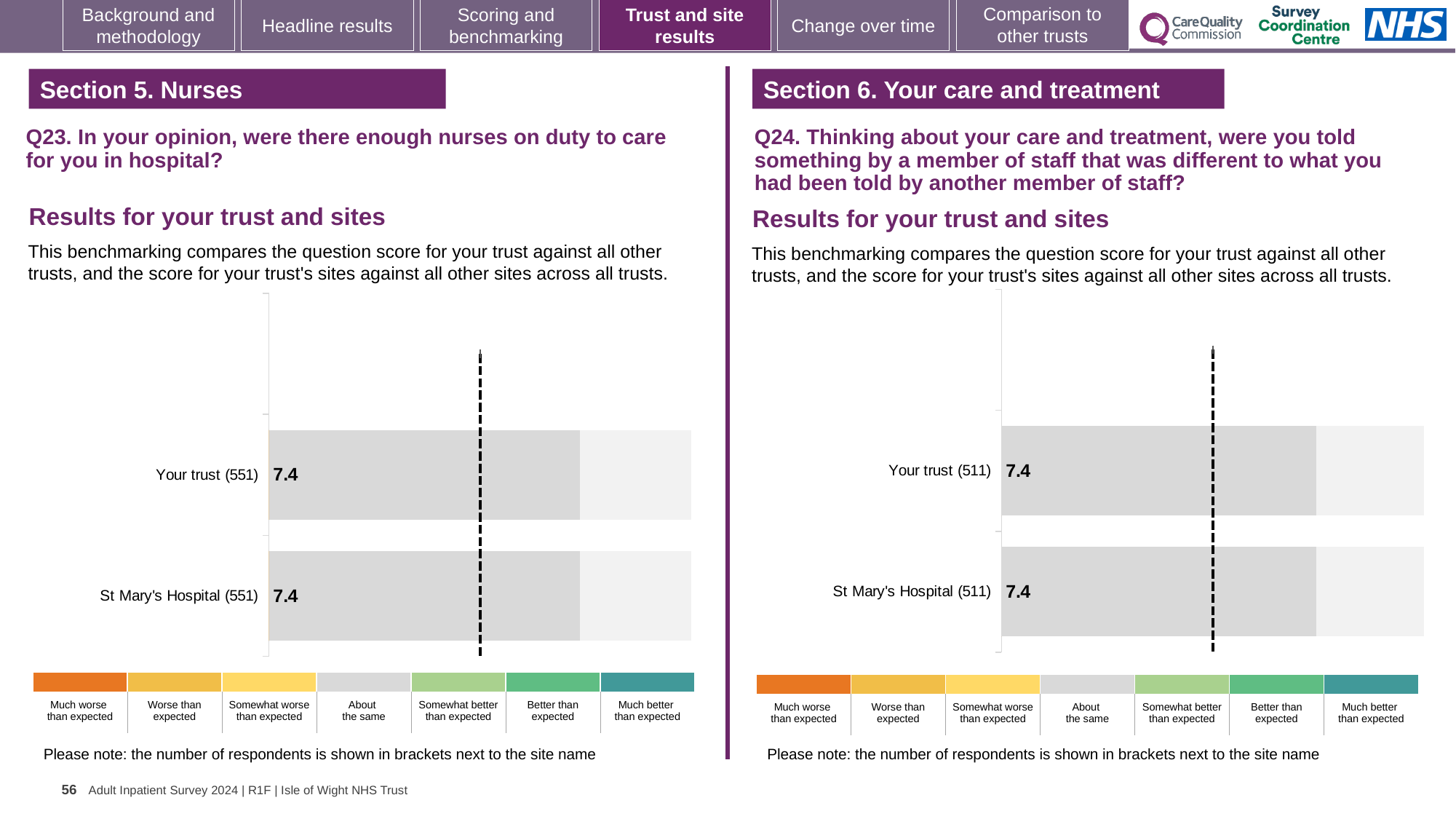
On the Q23 chart (left), how many respondents are shown in brackets next to Your trust? 551 On the Q24 chart (right), how many respondents are shown in brackets next to St Mary's Hospital? 511 How many bars are plotted on the Q23 chart (left)? 2 On the Q24 chart (right), what is the difference between the score for Your trust and the score for St Mary's Hospital? 0 On the Q23 chart (left), what is the difference between the score for Your trust and the score for St Mary's Hospital? 0 On the Q23 chart (left), what is the score for Your trust? 7.4 On the Q23 chart (left), what is the score for St Mary's Hospital? 7.4 On the Q24 chart (right), what is the score for St Mary's Hospital? 7.4 On the Q24 chart (right), what is the score for Your trust? 7.4 How many bars are plotted on the Q24 chart (right)? 2 What kind of chart is used on the Q23 chart (left)? Bar chart On the Q24 chart (right), which category label appears in the middle of the colour key below the chart? About the same